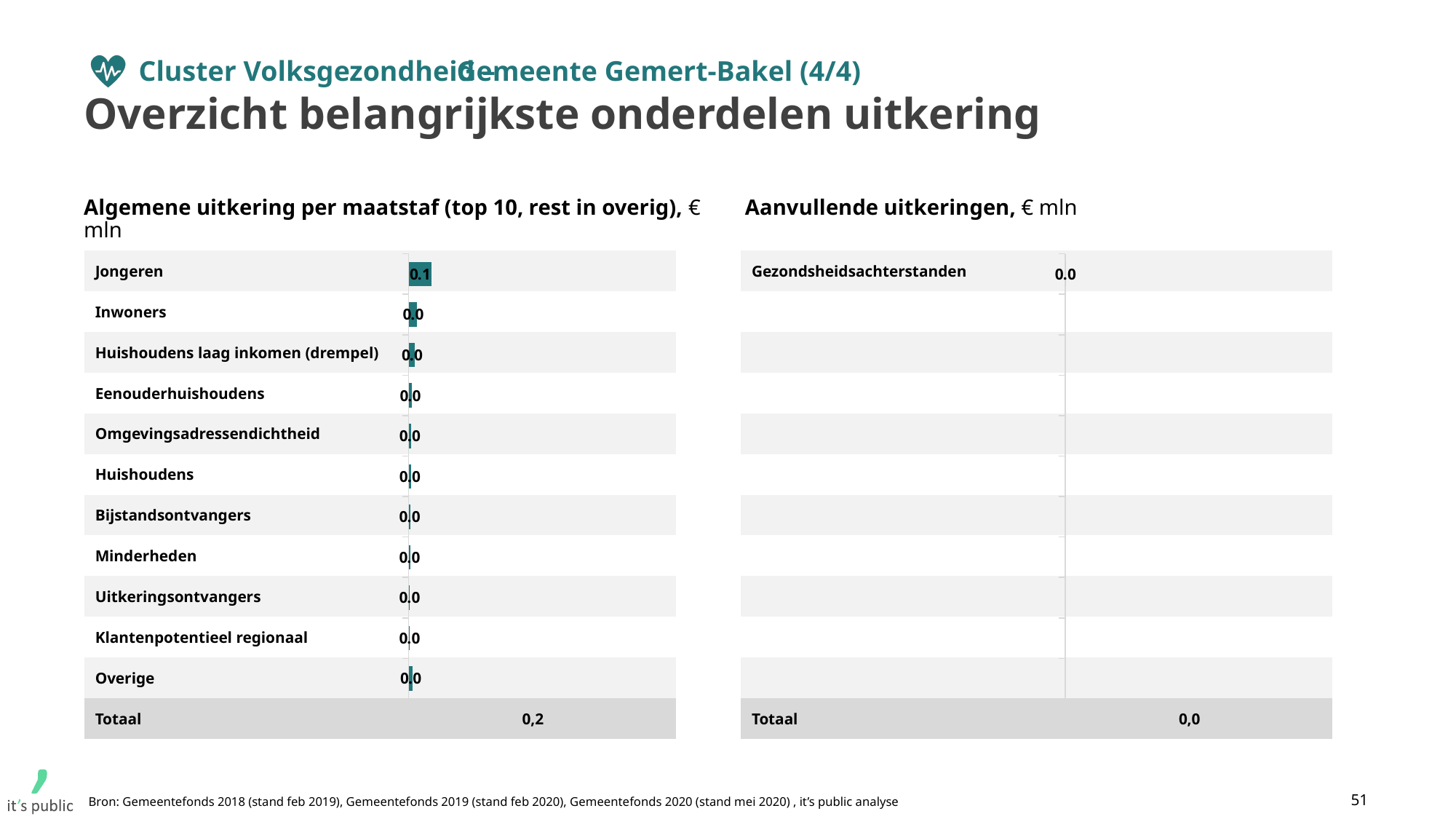
What unit is stated in the title of the right chart (Aanvullende uitkeringen)? € mln In the left chart (Algemene uitkering per maatstaf), which category has the highest value? Jongeren In the left chart (Algemene uitkering per maatstaf), what is the value for Inwoners? 0.0 In the left chart (Algemene uitkering per maatstaf), what is the value for Jongeren? 0.1 How many categories (excluding the Totaal row) are shown in the left chart (Algemene uitkering per maatstaf)? 11 What kind of chart is the left chart (Algemene uitkering per maatstaf)? Bar chart In the right chart (Aanvullende uitkeringen), what is the value for Gezondsheidsachterstanden? 0.0 In the left chart (Algemene uitkering per maatstaf), what is the difference between the value for Jongeren and the value for Inwoners? 0.1 How many categories (excluding the Totaal row) are shown in the right chart (Aanvullende uitkeringen)? 1 What value is shown in the Totaal row of the left chart (Algemene uitkering per maatstaf)? 0,2 In the left chart (Algemene uitkering per maatstaf), what is the value for Overige? 0.0 In the left chart (Algemene uitkering per maatstaf), which is larger: the value for Jongeren or the value for Huishoudens? Jongeren